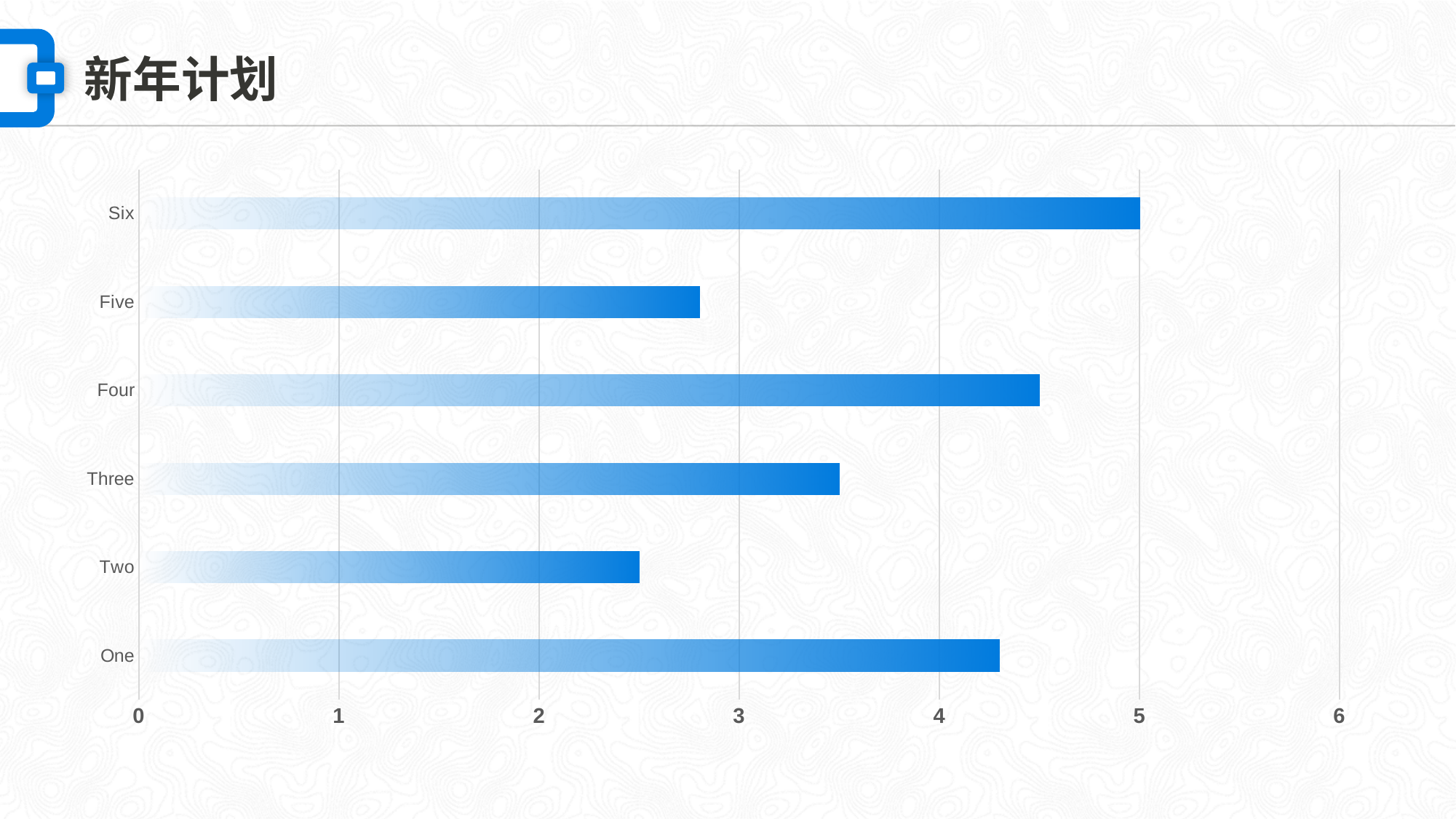
Is the value for Three greater or less than 3? greater What kind of chart is shown on the slide? bar chart How many categories are plotted in the chart? 6 Is the value for Four greater or less than 4? greater What is the title shown at the top of the slide? 新年计划 Which category has the highest value? Six Is the value for One greater or less than 4? greater Which is larger, the value for Six or the value for Five? Six What is the value for Six? 5 Which category has the lowest value? Two